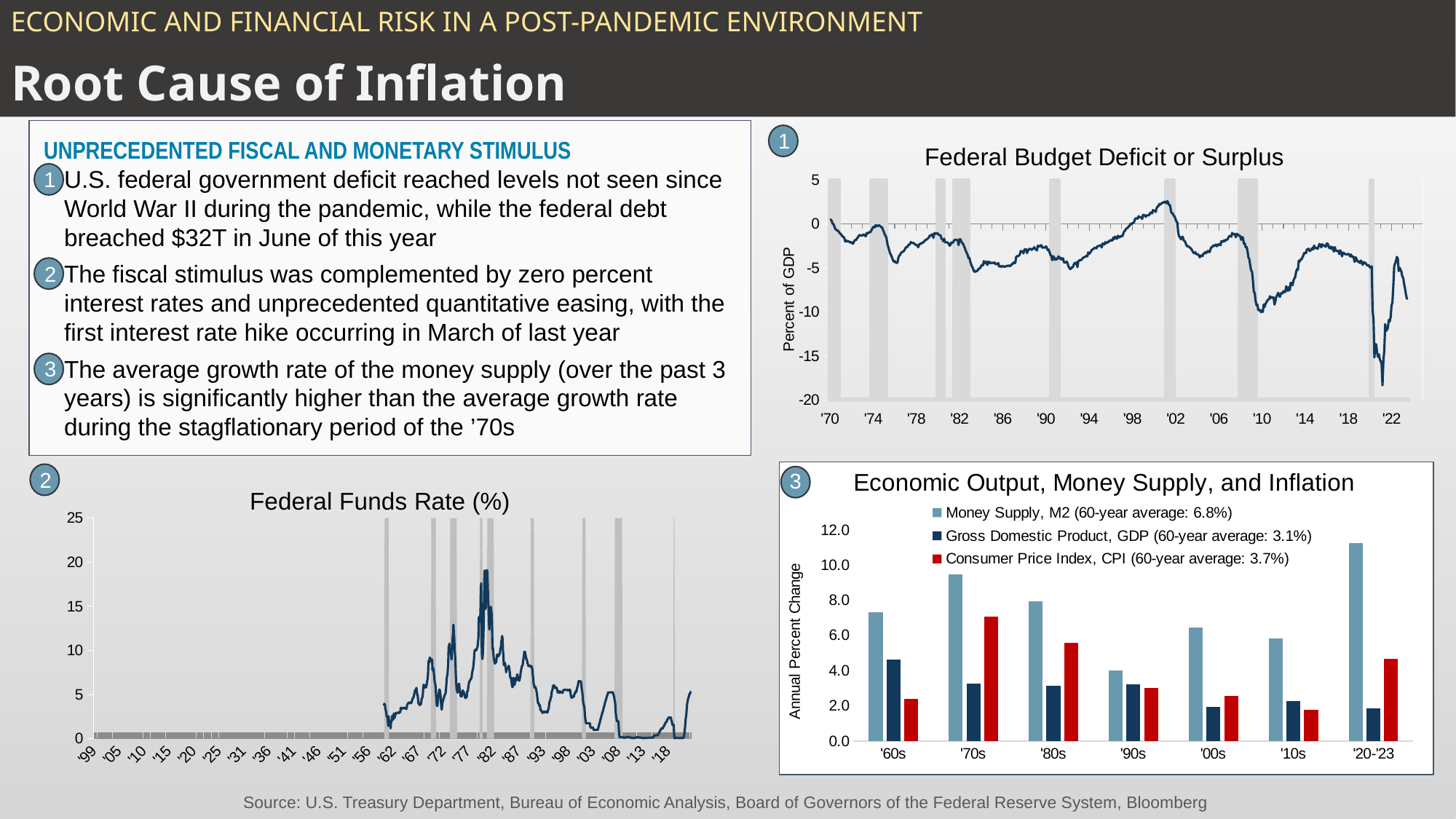
In the 'Economic Output, Money Supply, and Inflation' chart, which category has the lowest Money Supply, M2 value? '90s In the 'Economic Output, Money Supply, and Inflation' chart, is the Consumer Price Index, CPI value for the '10s greater or less than 2.0? less What type of chart is the 'Federal Budget Deficit or Surplus' chart? line chart How many series does the legend of the 'Economic Output, Money Supply, and Inflation' chart list? 3 According to the legend of the 'Economic Output, Money Supply, and Inflation' chart, what is the 60-year average for Money Supply, M2? 6.8% In the 'Economic Output, Money Supply, and Inflation' chart, which category has the highest Consumer Price Index, CPI value? '70s In the 'Economic Output, Money Supply, and Inflation' chart, is the Money Supply, M2 value for '20-'23 greater or less than 10.0? greater In the 'Economic Output, Money Supply, and Inflation' chart, which is larger: the Money Supply, M2 value for the '70s or for the '80s? '70s In the 'Federal Funds Rate (%)' chart, is the peak value around '82 greater or less than 15? greater How many decade categories are shown on the x axis of the 'Economic Output, Money Supply, and Inflation' chart? 7 What type of chart is the 'Economic Output, Money Supply, and Inflation' chart? bar chart In the 'Economic Output, Money Supply, and Inflation' chart, which category has the highest Money Supply, M2 value? '20-'23